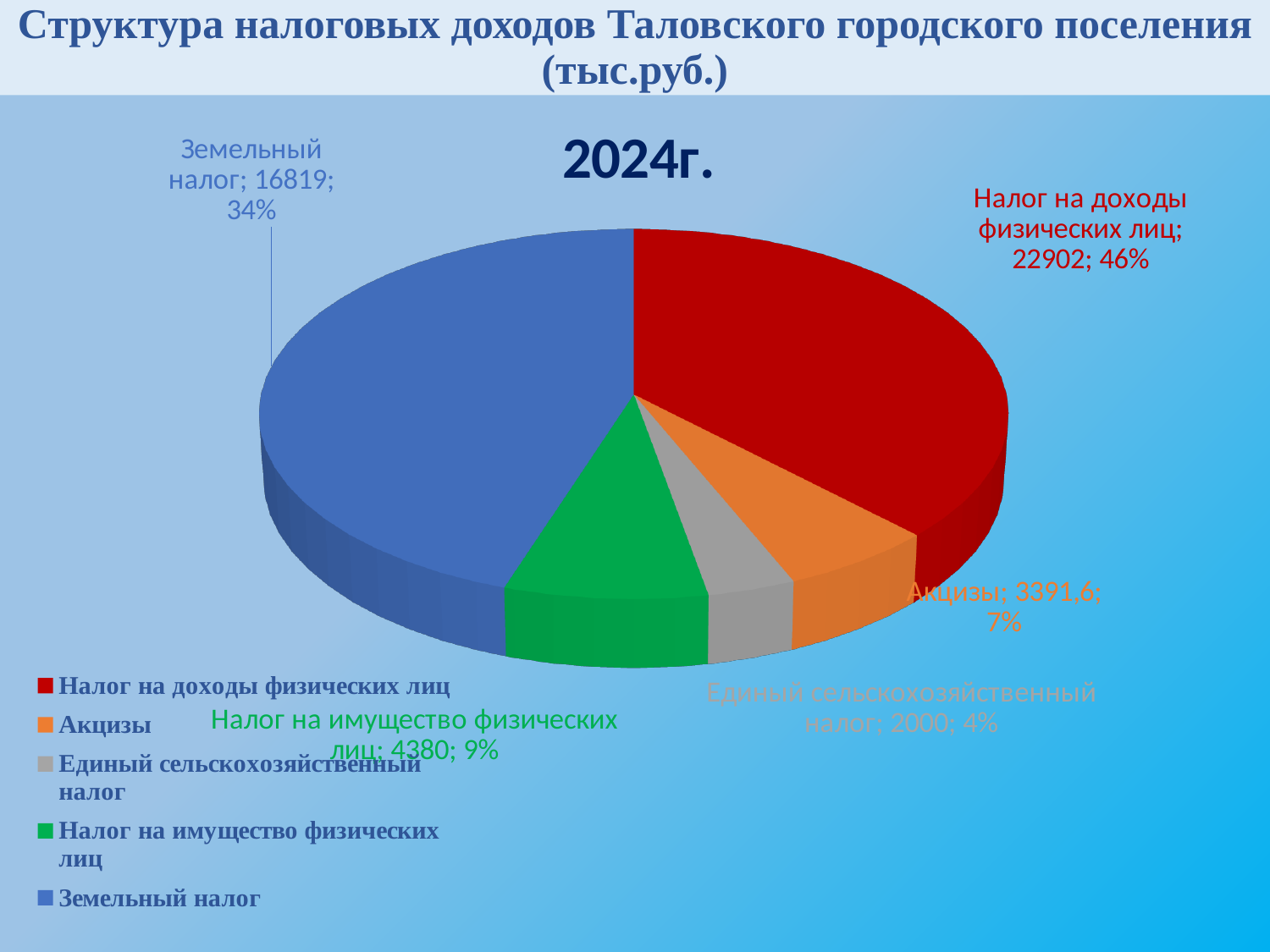
What is the value for Единый сельскохозяйственный налог in the pie chart? 2000 Which category has the smallest slice in the pie chart? Единый сельскохозяйственный налог What is the difference between the values for Налог на доходы физических лиц and Земельный налог? 6083 What kind of chart is shown on the slide? pie chart Which is larger: the value for Акцизы or the value for Налог на имущество физических лиц? Налог на имущество физических лиц How many categories does the legend of the pie chart list? 5 What is the value for Акцизы in the pie chart? 3391,6 What is the value for Земельный налог in the pie chart? 16819 What share of the pie does Земельный налог represent? 34% What share of the pie does Налог на имущество физических лиц represent? 9% What is the value for Налог на доходы физических лиц in the 2024г. pie chart? 22902